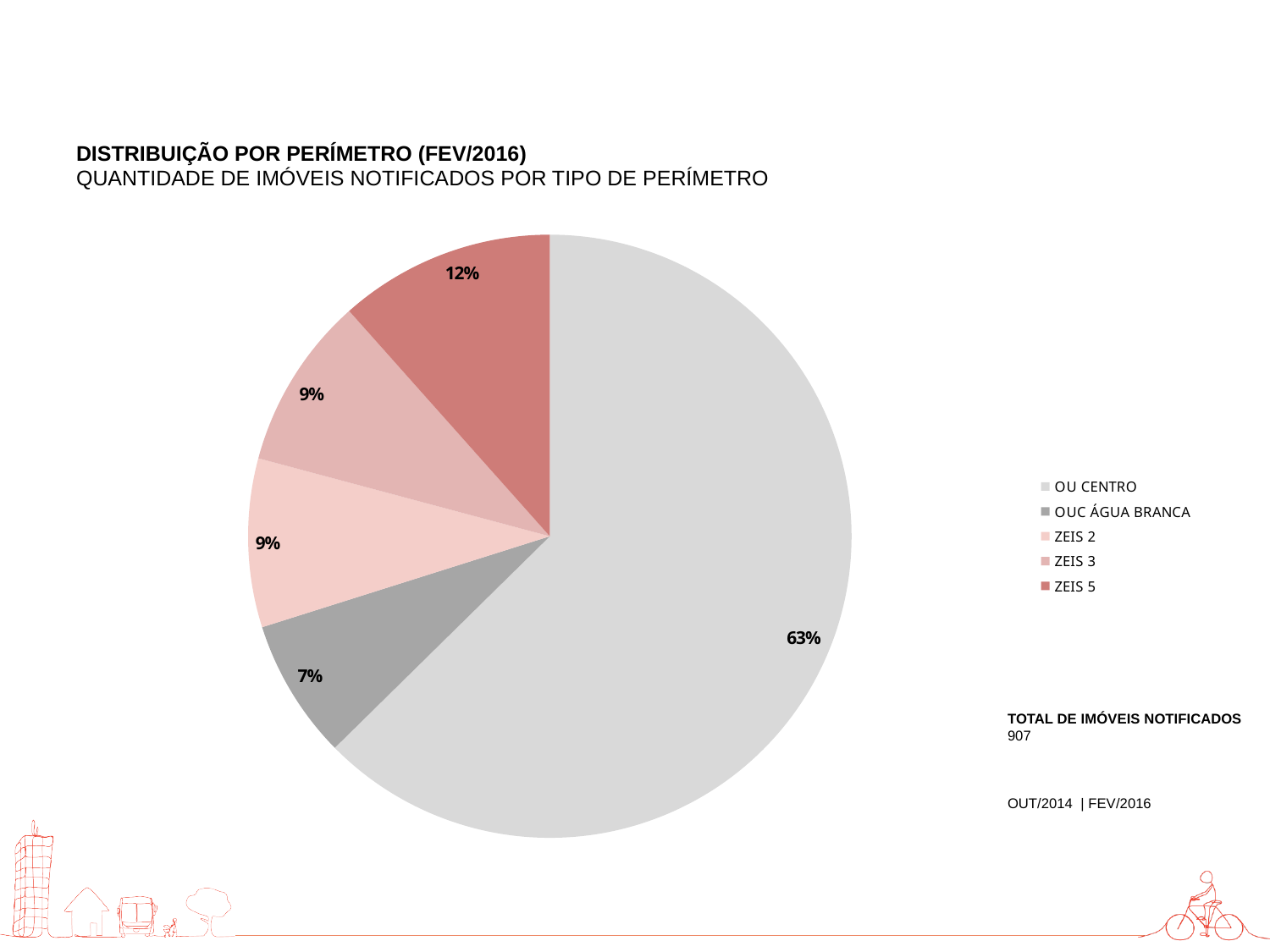
What is the difference in percentage points between ZEIS 5 and ZEIS 3? 3 What is the value shown for ZEIS 5? 12% What share of the pie does OU CENTRO represent? 63% What is the value shown for ZEIS 2? 9% What is the value shown for OUC ÁGUA BRANCA? 7% How many categories does the legend list? 5 Which category has the smallest slice of the pie? OUC ÁGUA BRANCA Which category has the largest slice of the pie? OU CENTRO What type of chart is shown on the slide? pie chart Which is larger, the slice for ZEIS 5 or the slice for OUC ÁGUA BRANCA? ZEIS 5 What is the difference in percentage points between OU CENTRO and ZEIS 5? 51 What total number of notified properties is stated next to the chart? 907